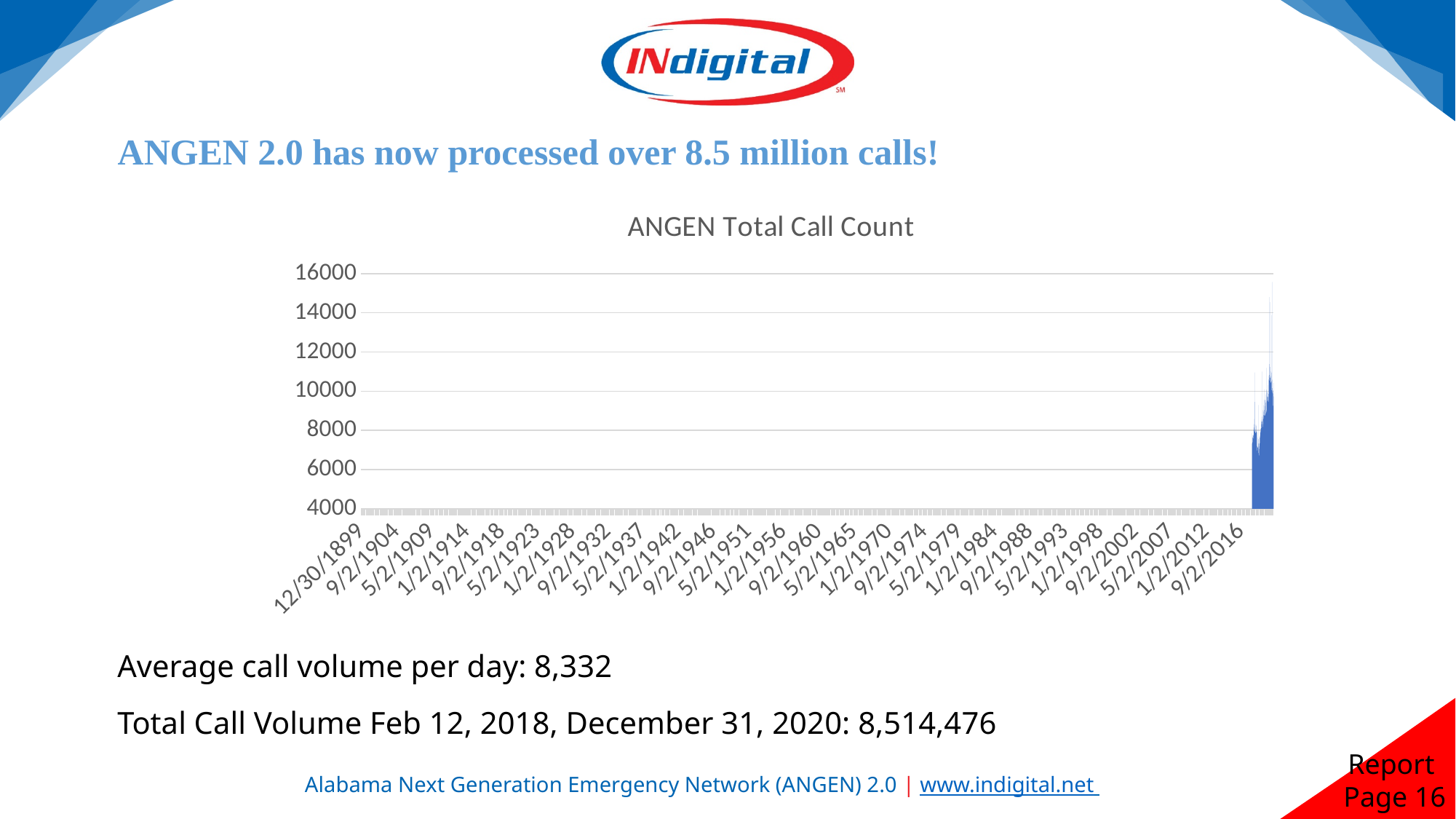
What is the title of the chart? ANGEN Total Call Count What colour are the bars in the chart? blue Is the highest plotted call count greater or less than 12000? greater What is the lowest value shown on the chart's vertical axis? 4000 Do the plotted call counts rise or fall toward the right end of the horizontal axis? rise What is the first date label on the chart's horizontal axis? 12/30/1899 What is the last date label on the chart's horizontal axis? 9/2/2016 What kind of chart is shown on the slide? bar chart